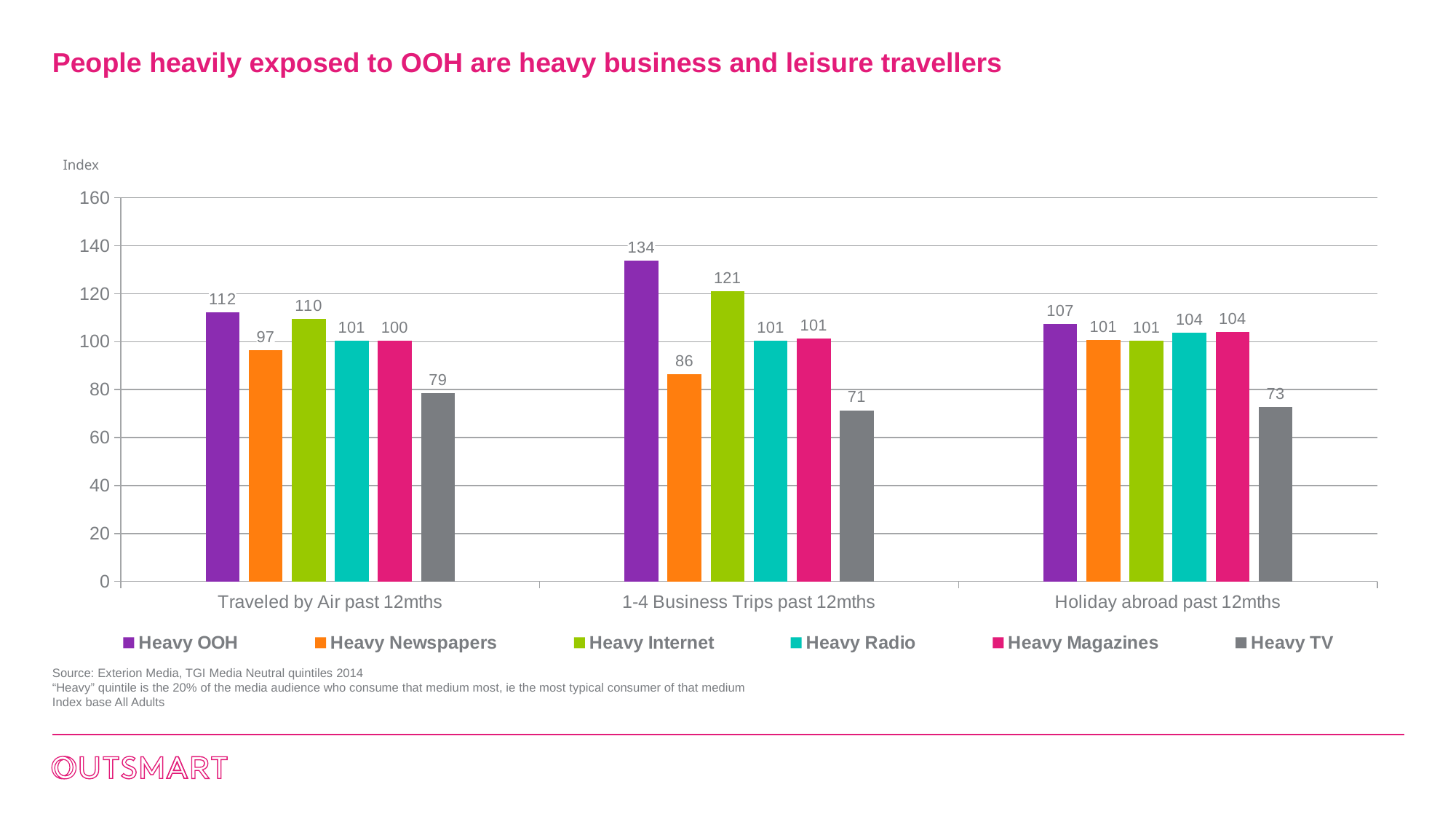
What is the title of the slide? People heavily exposed to OOH are heavy business and leisure travellers Which series has the highest index value in the '1-4 Business Trips past 12mths' category? Heavy OOH Is the value for Heavy Internet in the '1-4 Business Trips past 12mths' category greater or less than 120? greater What is the index value for Heavy OOH in the '1-4 Business Trips past 12mths' category? 134 What kind of chart is shown on the slide? Bar chart What is the index value for Heavy Internet in the 'Holiday abroad past 12mths' category? 101 What is the difference between the Heavy OOH and Heavy Newspapers index values in the '1-4 Business Trips past 12mths' category? 48 Which is larger in the 'Traveled by Air past 12mths' category: Heavy OOH or Heavy Internet? Heavy OOH How many series does the legend list? 6 How many categories are shown on the x axis? 3 What is the index value for Heavy TV in the 'Traveled by Air past 12mths' category? 79 Which series has the lowest index value in the 'Holiday abroad past 12mths' category? Heavy TV